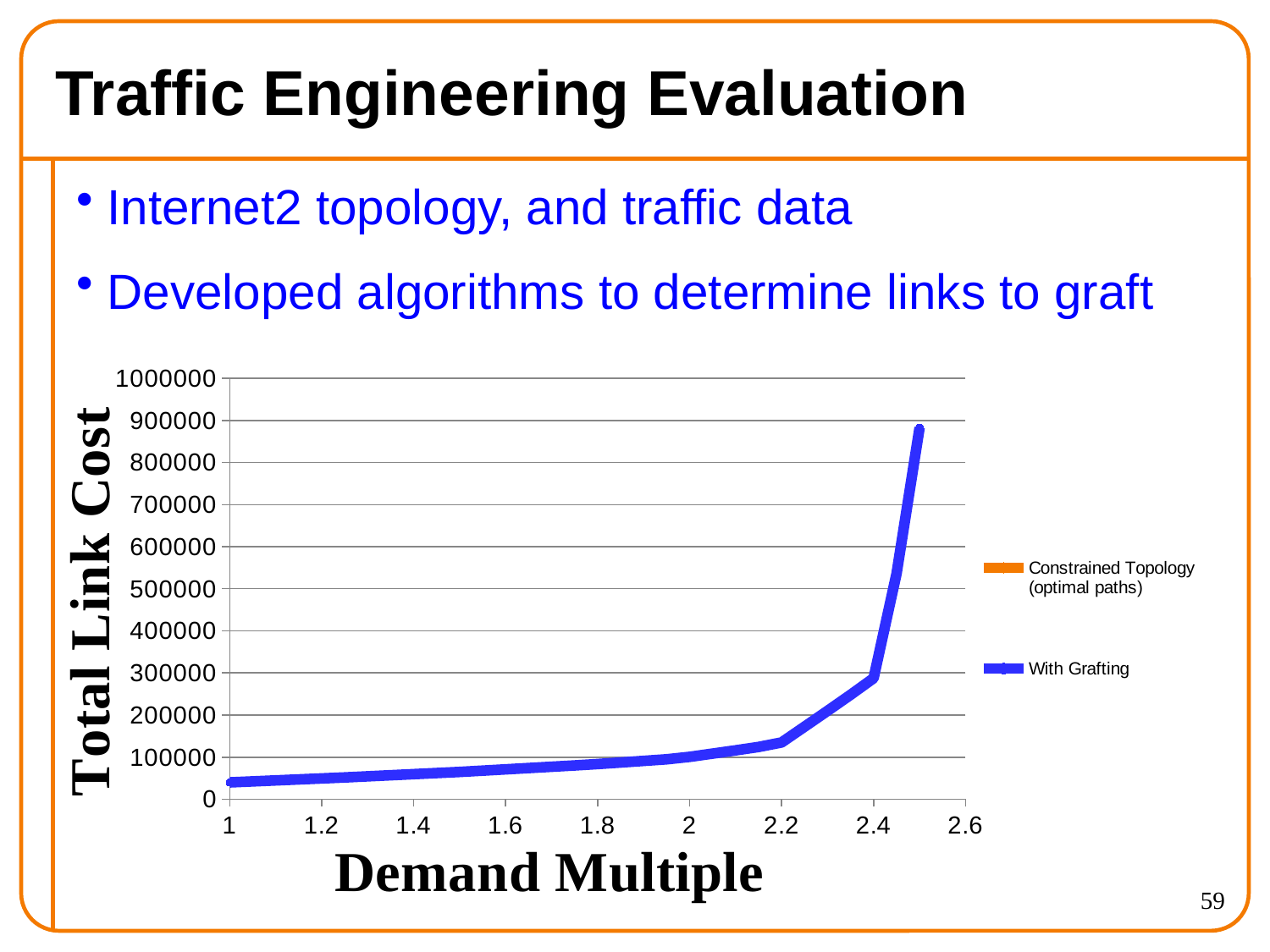
Is the Total Link Cost for With Grafting at Demand Multiple 2.5 greater or less than 800000? greater What is the title of the chart's x axis? Demand Multiple What kind of chart is shown on the slide? line chart What is the title of the chart's y axis? Total Link Cost Does the Total Link Cost for With Grafting rise or fall as the Demand Multiple increases? rise How many series does the chart's legend list? 2 At which Demand Multiple is the Total Link Cost for With Grafting highest? 2.5 Is the Total Link Cost for With Grafting at Demand Multiple 2.4 greater or less than 200000? greater Which is larger for With Grafting: the Total Link Cost at Demand Multiple 2.4 or at Demand Multiple 2.2? 2.4 At which Demand Multiple is the Total Link Cost for With Grafting lowest? 1 Is the Total Link Cost for With Grafting at Demand Multiple 1 greater or less than 100000? less